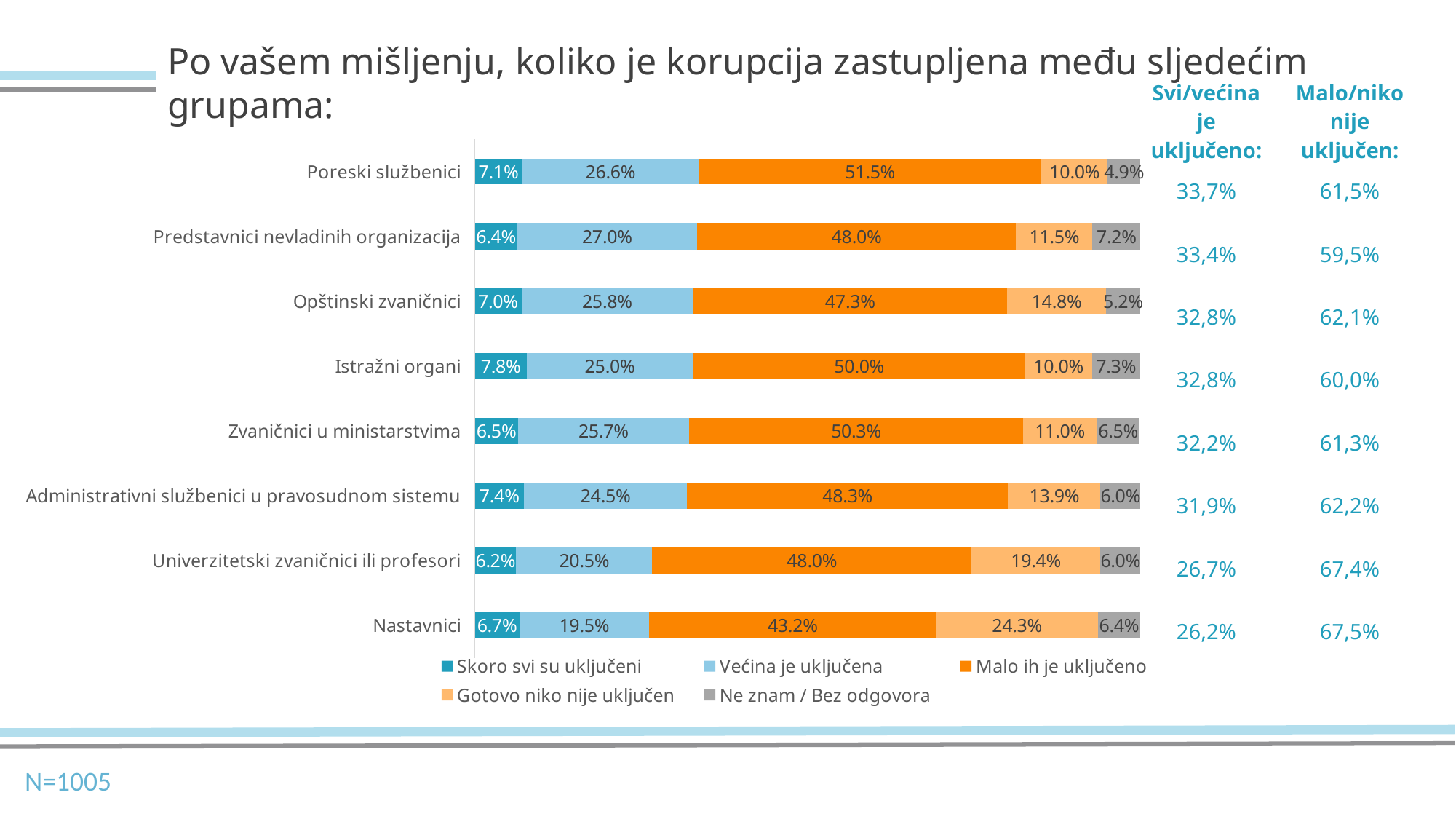
How many groups (categories) are shown in the chart? 8 Which group has the lowest value for 'Većina je uključena'? Nastavnici How many series does the legend list? 5 Which is larger: the 'Većina je uključena' value for Predstavnici nevladinih organizacija or for Univerzitetski zvaničnici ili profesori? Predstavnici nevladinih organizacija What is the value of 'Gotovo niko nije uključen' for Nastavnici? 24.3% What kind of chart is shown on the slide? Stacked bar chart Which group has the highest value for 'Malo ih je uključeno'? Poreski službenici What is the difference between the 'Gotovo niko nije uključen' values for Nastavnici and Poreski službenici? 14.3 percentage points Which series is shown in dark grey in the legend? Ne znam / Bez odgovora Which group has the highest value for 'Gotovo niko nije uključen'? Nastavnici What is the value of 'Skoro svi su uključeni' for Istražni organi? 7.8% What is the value of 'Malo ih je uključeno' for Poreski službenici? 51.5%